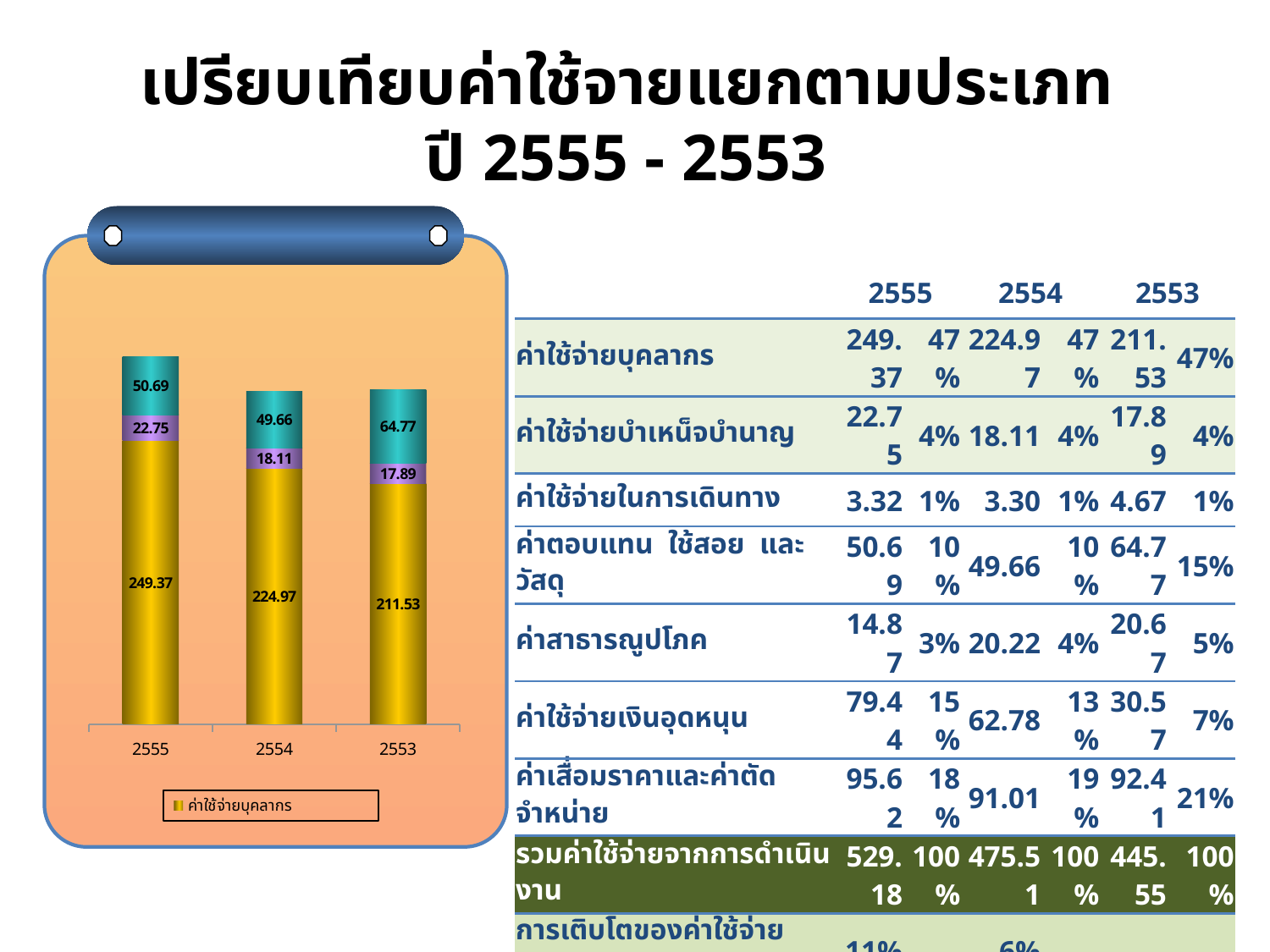
How many year categories are shown on the x axis of the chart? 3 Does the gold (ค่าใช้จ่ายบุคลากร) segment rise or fall moving from 2555 to 2553 along the x axis? fall What type of chart is shown on the slide? bar chart What is the difference between the gold segment values for 2555 and 2554? 24.40 What is the value of the gold (ค่าใช้จ่ายบุคลากร) segment for 2555? 249.37 What is the total of the stacked bar for 2555? 322.81 Which year has the highest value for the gold (ค่าใช้จ่ายบุคลากร) segment? 2555 How many series does the chart's legend list? 1 Which is larger: the teal segment for 2553 or the teal segment for 2555? 2553 What is the value of the teal (top) segment for 2553? 64.77 Which year has the lowest value for the teal (top) segment? 2554 What is the value of the purple (middle) segment for 2554? 18.11